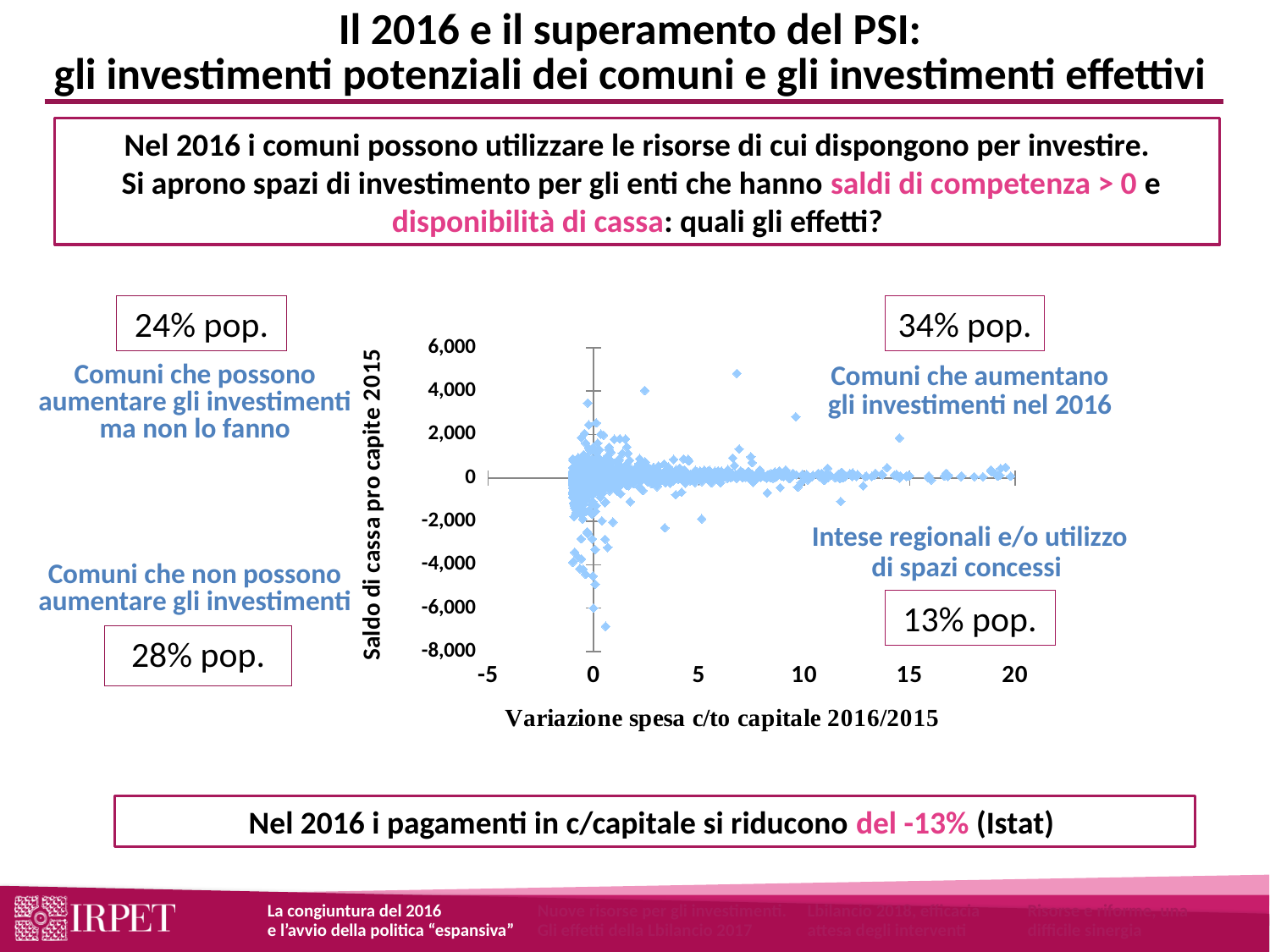
What kind of chart is shown on the slide? scatter plot What is the highest tick value shown on the vertical axis of the scatter plot? 6,000 What is the largest tick value shown on the horizontal axis of the scatter plot? 20 What is the label of the vertical axis of the scatter plot? Saldo di cassa pro capite 2015 What share of population is indicated for the group 'Intese regionali e/o utilizzo di spazi concessi'? 13% pop. What is the label of the horizontal axis of the scatter plot? Variazione spesa c/to capitale 2016/2015 What is the smallest tick value shown on the horizontal axis of the scatter plot? -5 What share of population is indicated for the group 'Comuni che possono aumentare gli investimenti ma non lo fanno'? 24% pop. What is the lowest tick value shown on the vertical axis of the scatter plot? -8,000 What share of population is indicated for the group 'Comuni che non possono aumentare gli investimenti'? 28% pop. What share of population is indicated for the group 'Comuni che aumentano gli investimenti nel 2016'? 34% pop. Is the highest point in the scatter plot greater or less than 4,000 on the vertical axis? greater